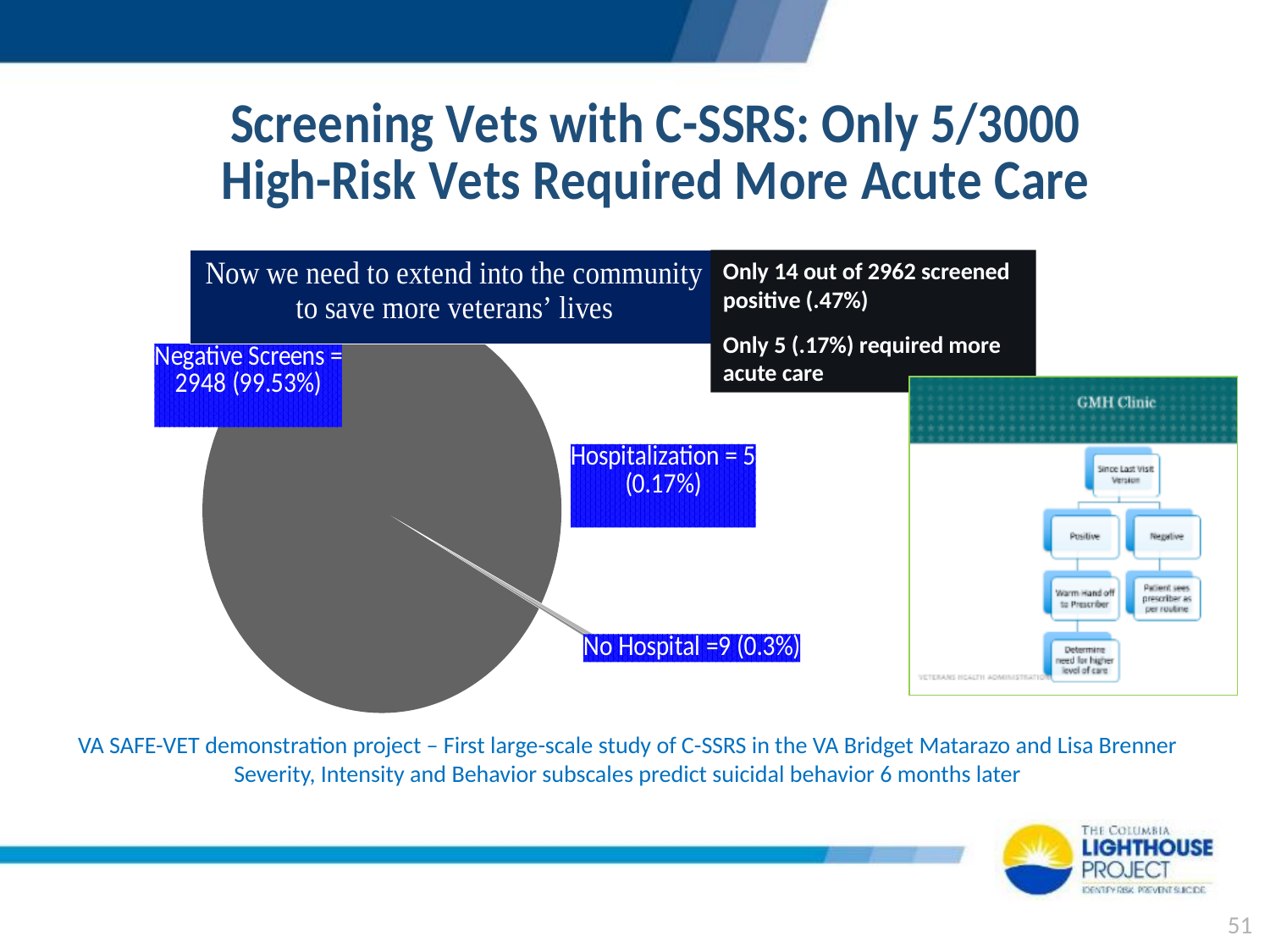
What share of the pie do Negative Screens represent? 99.53% What kind of chart is shown on the slide? pie chart What share of the pie does No Hospital represent? 0.3% What is the difference between the No Hospital value and the Hospitalization value? 4 Which slice of the pie chart is the smallest? Hospitalization How many slices does the pie chart have? 3 What is the value for No Hospital in the pie chart? 9 Which is larger, the No Hospital value or the Hospitalization value? No Hospital What share of the pie does Hospitalization represent? 0.17% What is the value for Negative Screens in the pie chart? 2948 Which slice of the pie chart is the largest? Negative Screens What is the value for Hospitalization in the pie chart? 5